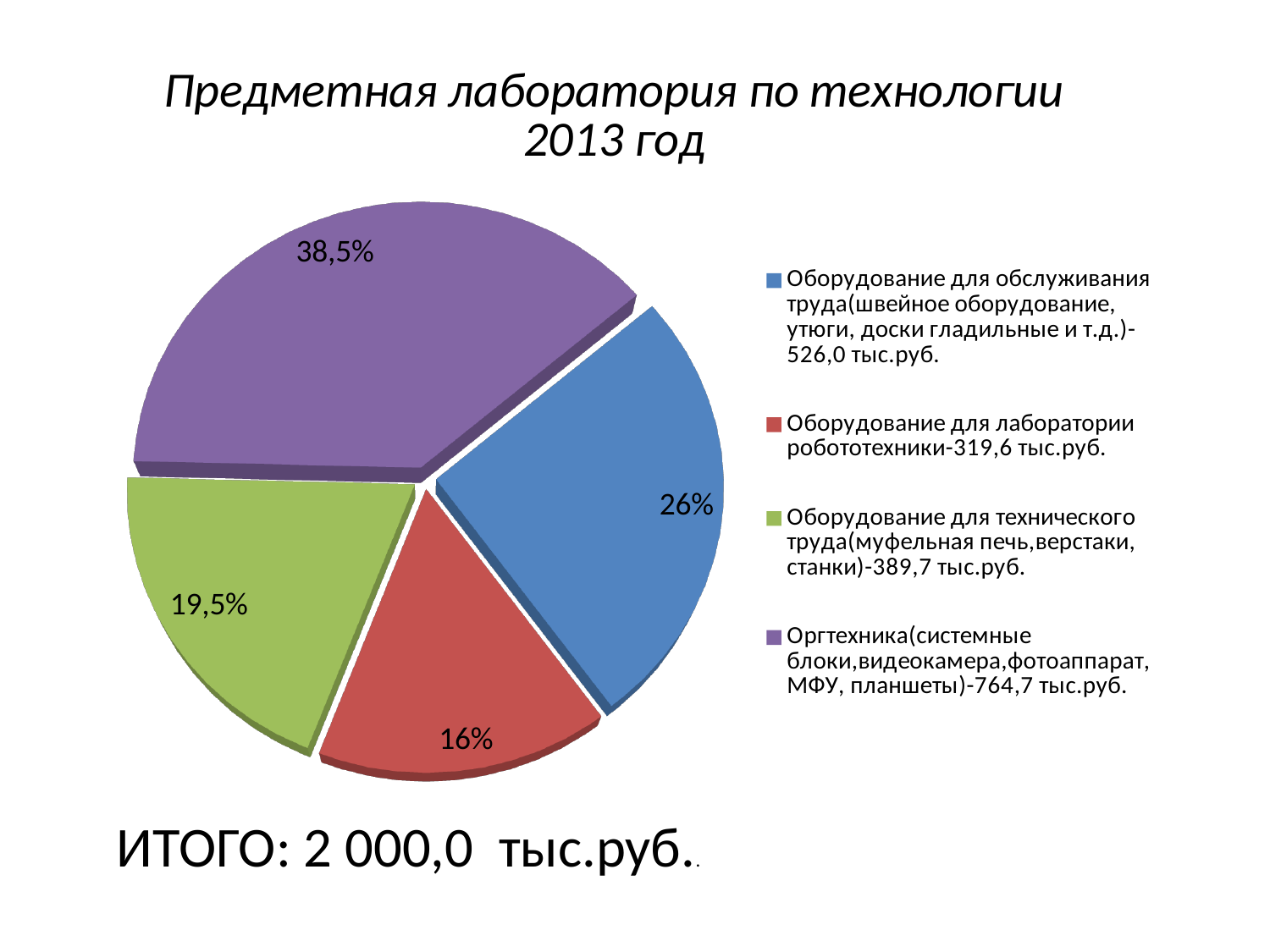
What percentage is shown for Оборудование для технического труда (муфельная печь, верстаки, станки)? 19,5% What percentage is shown for Оборудование для лаборатории робототехники? 16% What percentage is shown for Оборудование для обслуживания труда (швейное оборудование, утюги, доски гладильные и т.д.)? 26% Which is larger: the slice for Оборудование для технического труда or the slice for Оборудование для лаборатории робототехники? Оборудование для технического труда What kind of chart is shown on the slide? pie chart What is the difference in percentage points between the Оргтехника slice and the Оборудование для обслуживания труда slice? 12,5 Which category has the largest slice of the pie? Оргтехника How many slices does the pie chart have? 4 What total amount (ИТОГО) is stated below the chart? 2 000,0 тыс.руб. What share of the pie is labelled for Оргтехника (системные блоки, видеокамера, фотоаппарат, МФУ, планшеты)? 38,5% Which category has the smallest slice of the pie? Оборудование для лаборатории робототехники How many entries does the legend list? 4